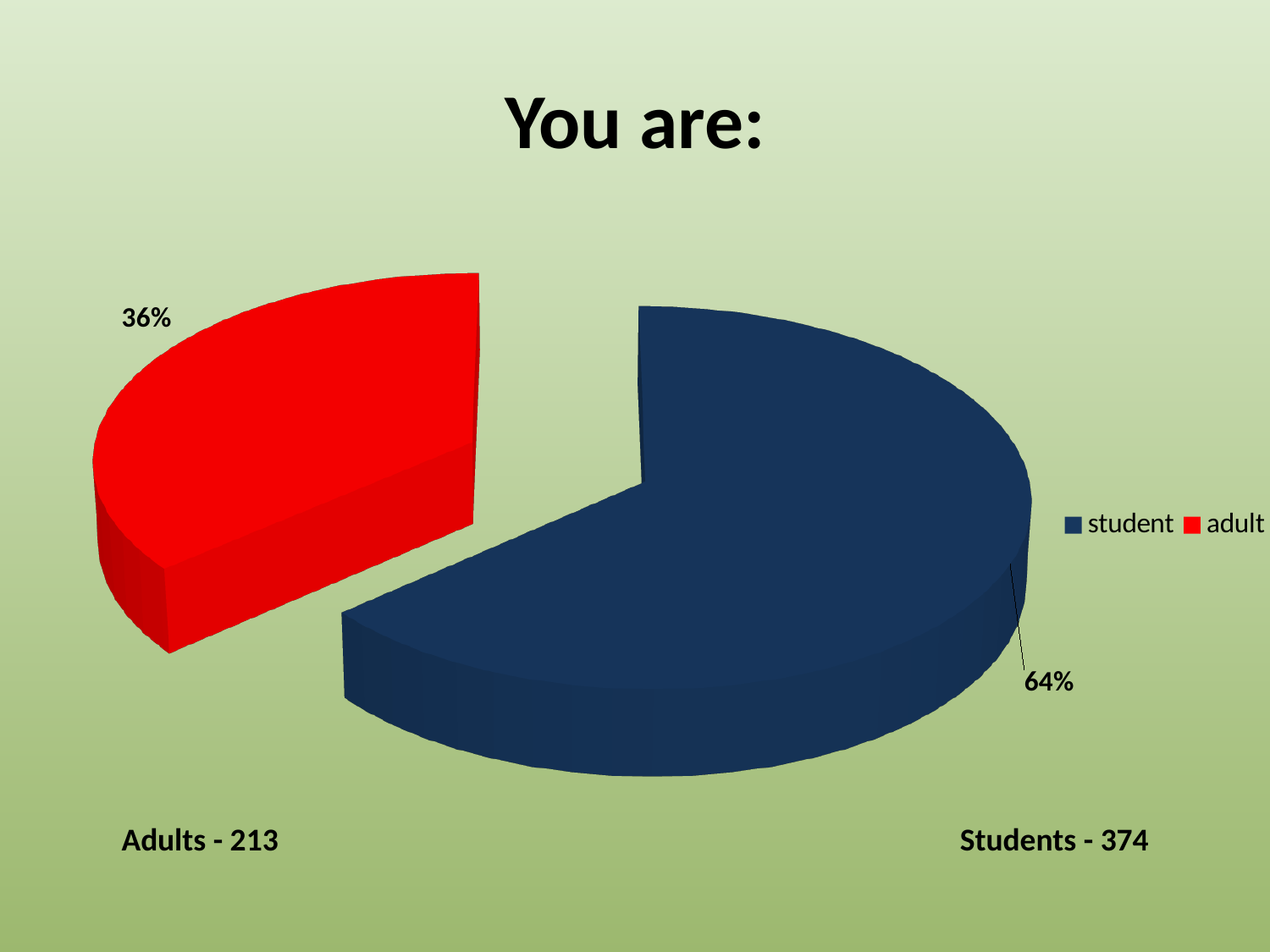
What colour is the adult slice? red What percentage of the pie does the adult slice represent? 36% What is the difference in percentage points between the student and adult slices? 28 Is the share for the student slice greater or less than 50%? greater What percentage of the pie does the student slice represent? 64% How many entries does the legend list? 2 What kind of chart is shown on the slide? pie chart How many slices does the pie chart have? 2 Which slice is larger, student or adult? student Which category has the largest share of the pie? student Which category has the smallest share of the pie? adult What is the title of the slide? You are: